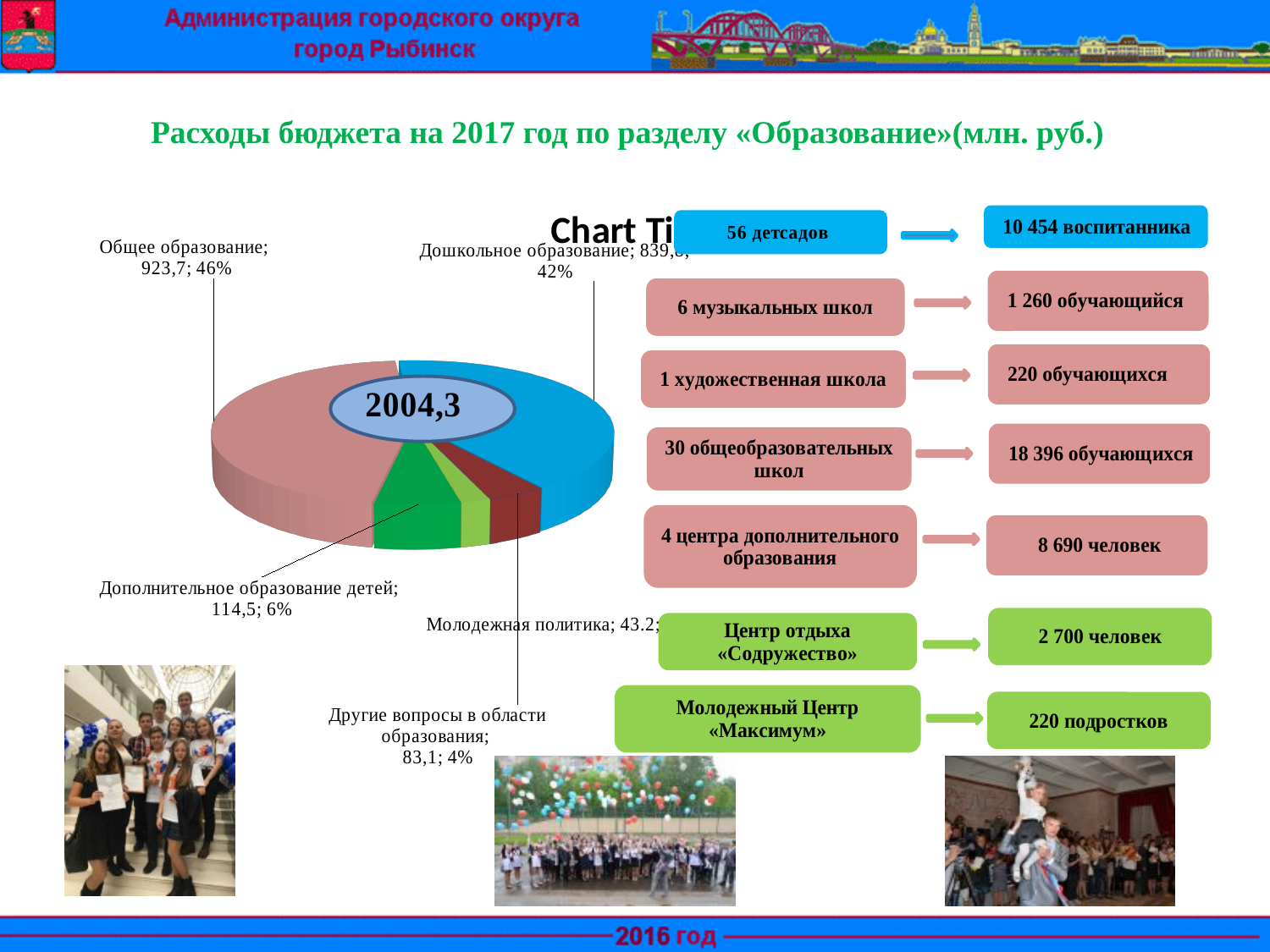
What is the value for Дополнительное образование детей in the pie chart? 114,5 What is the value for Другие вопросы в области образования in the pie chart? 83,1 Which category has the smallest slice of the pie chart? Молодежная политика How many categories are shown in the pie chart? 5 What share of the pie does Дошкольное образование take? 42% What is the difference between the values for Общее образование and Дополнительное образование детей? 809,2 What is the value for Общее образование in the pie chart? 923,7 What total value is shown in the centre of the pie chart? 2004,3 What is the value for Молодежная политика in the pie chart? 43.2 What share of the pie does Общее образование take? 46% Which category has the largest slice of the pie chart? Общее образование What kind of chart is shown on the slide? pie chart